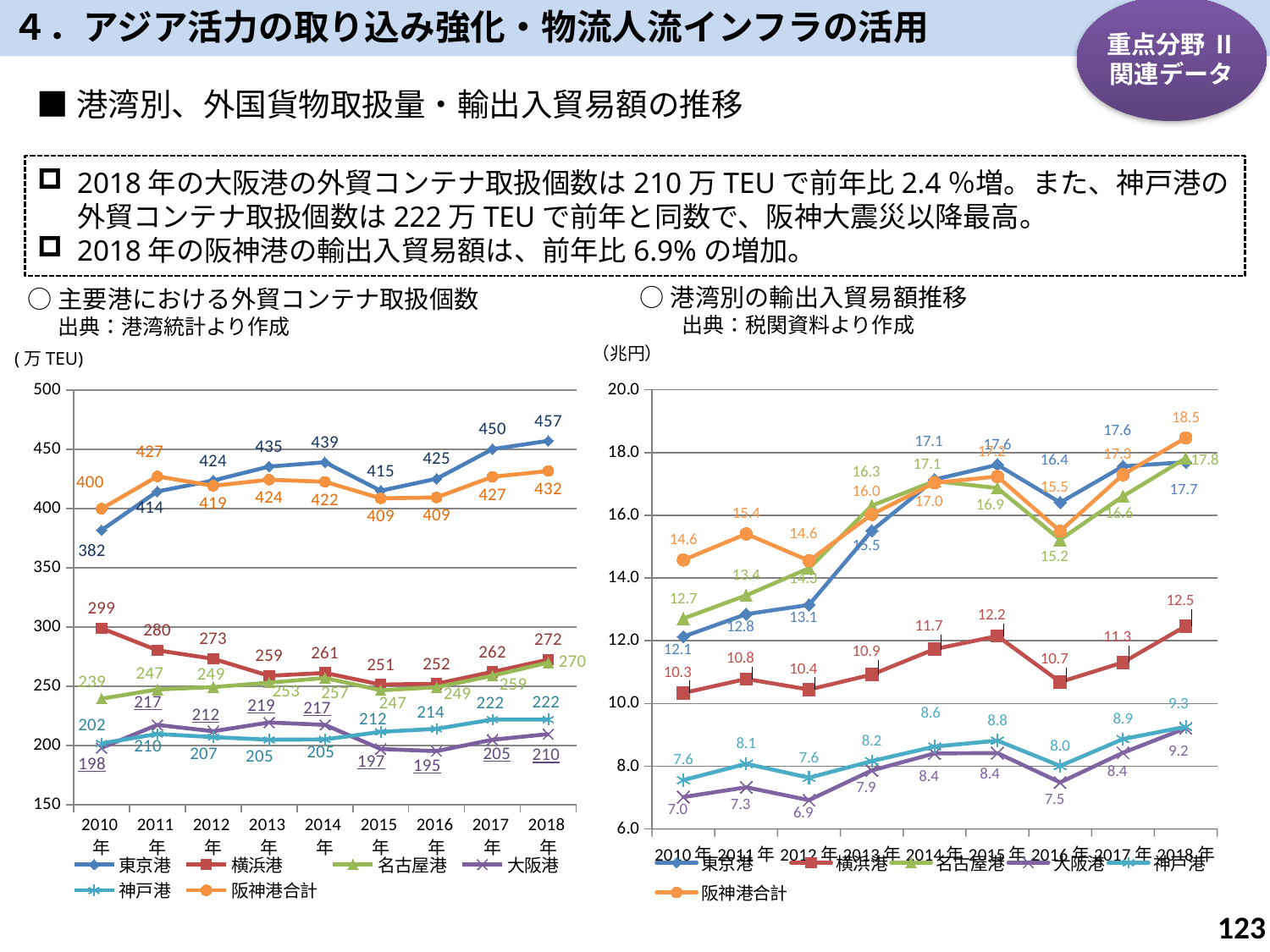
In the left chart (主要港における外貿コンテナ取扱個数), how many series does the legend list? 6 In the right chart (港湾別の輸出入貿易額推移), which series has the highest value in 2018年? 阪神港合計 In the left chart (主要港における外貿コンテナ取扱個数), what is the value for 東京港 in 2018年? 457 In the left chart (主要港における外貿コンテナ取扱個数), which year has the lowest value for 東京港? 2010年 In the left chart (主要港における外貿コンテナ取扱個数), what is the value for 横浜港 in 2010年? 299 In the right chart (港湾別の輸出入貿易額推移), what is the value for 大阪港 in 2012年? 6.9 What kind of chart is the left chart (主要港における外貿コンテナ取扱個数)? line chart In the left chart (主要港における外貿コンテナ取扱個数), what is the value for 阪神港合計 in 2015年? 409 In the right chart (港湾別の輸出入貿易額推移), which is larger in 2015年, 横浜港 or 神戸港? 横浜港 In the right chart (港湾別の輸出入貿易額推移), how many years are plotted on the x axis? 9 In the left chart (主要港における外貿コンテナ取扱個数), what is the difference between 東京港 and 阪神港合計 in 2018年? 25 In the right chart (港湾別の輸出入貿易額推移), what is the value for 阪神港合計 in 2018年? 18.5